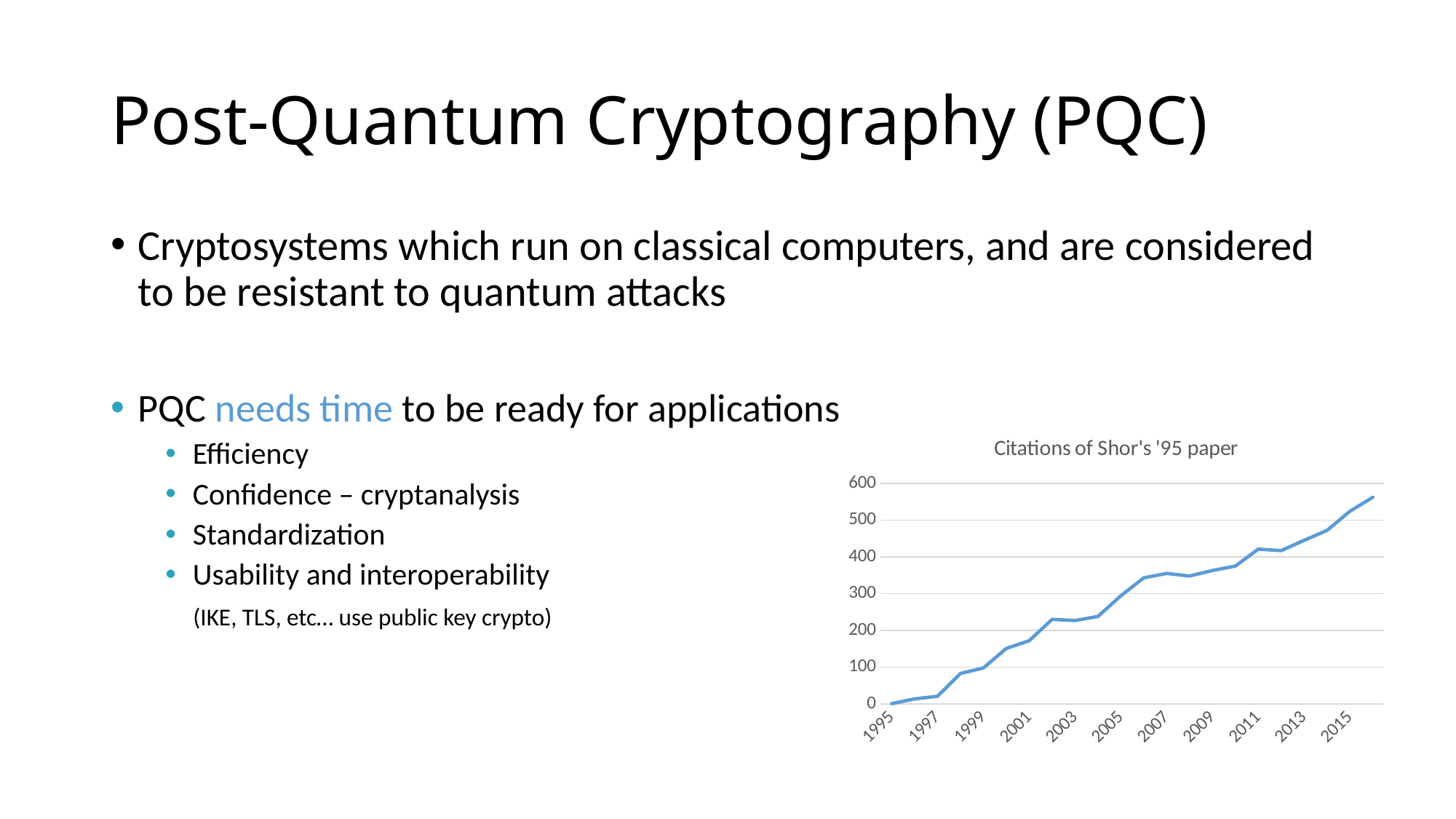
Which year has more citations, 2009 or 2003? 2009 Which year shown on the x axis has the lowest number of citations? 1995 What kind of chart is shown on the slide? line chart How many year labels are shown on the x axis of the chart? 11 Is the value for 2009 greater or less than 300? greater Is the value for 2001 greater or less than 200? less Is the value for 2005 greater or less than 200? greater Do the citation values rise or fall from 1995 to the right end of the chart? rise Which year has more citations, 2005 or 2013? 2013 What is the title of the chart on the slide? Citations of Shor's '95 paper